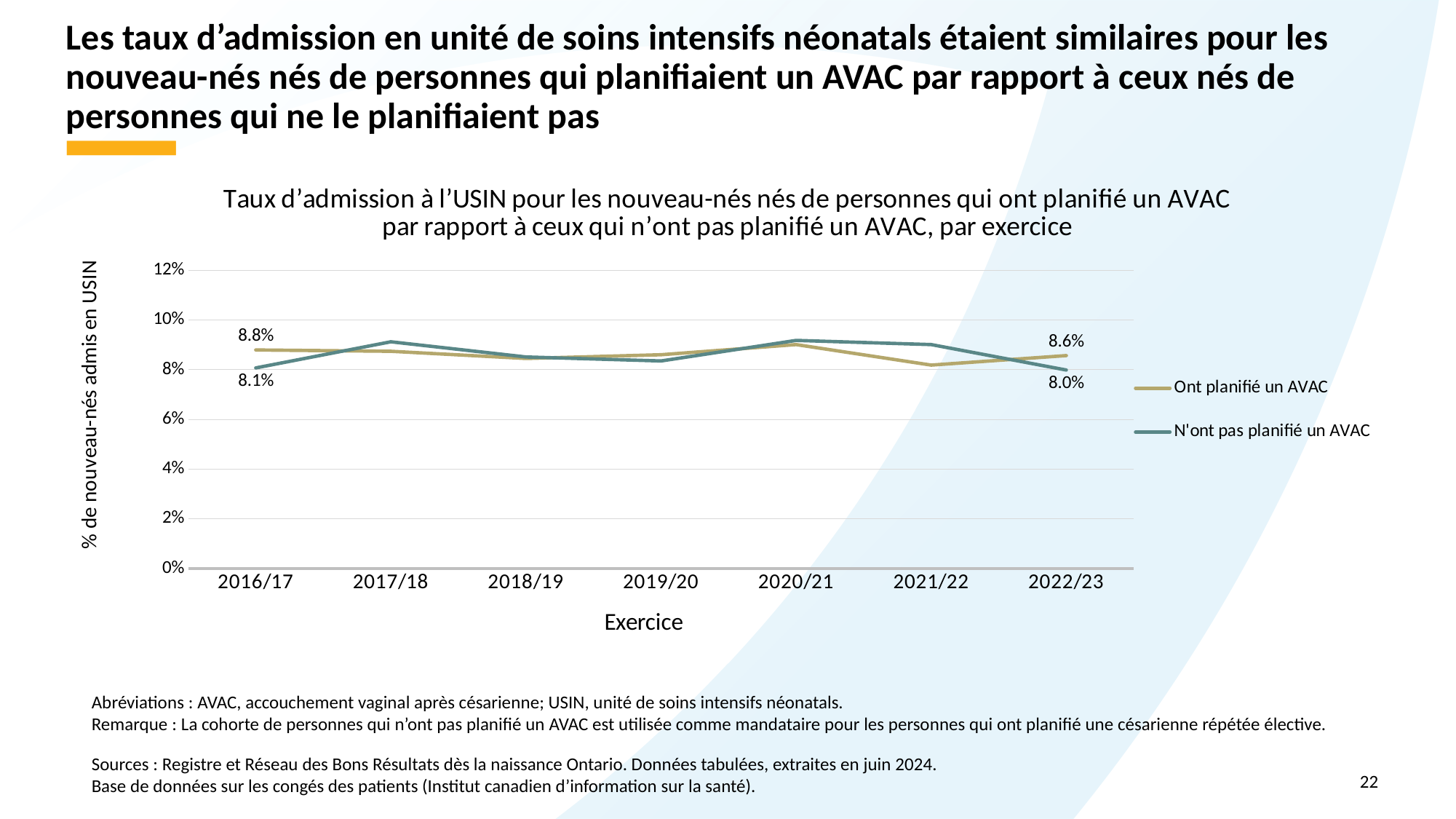
In 2022/23, which series has the higher value: "Ont planifié un AVAC" or "N'ont pas planifié un AVAC"? Ont planifié un AVAC What is the value for "N'ont pas planifié un AVAC" in 2022/23? 8.0% What is the difference between the two series' values in 2022/23? 0.6 percentage points What is the value for "Ont planifié un AVAC" in 2016/17? 8.8% What is the difference between the two series' values in 2016/17? 0.7 percentage points What is the title of the x axis? Exercice How many fiscal years (exercices) are shown on the x axis? 7 What kind of chart is this? Line chart Is the value for "N'ont pas planifié un AVAC" in 2017/18 greater or less than 8%? greater How many series does the legend list? 2 What is the value for "Ont planifié un AVAC" in 2022/23? 8.6% What is the value for "N'ont pas planifié un AVAC" in 2016/17? 8.1%